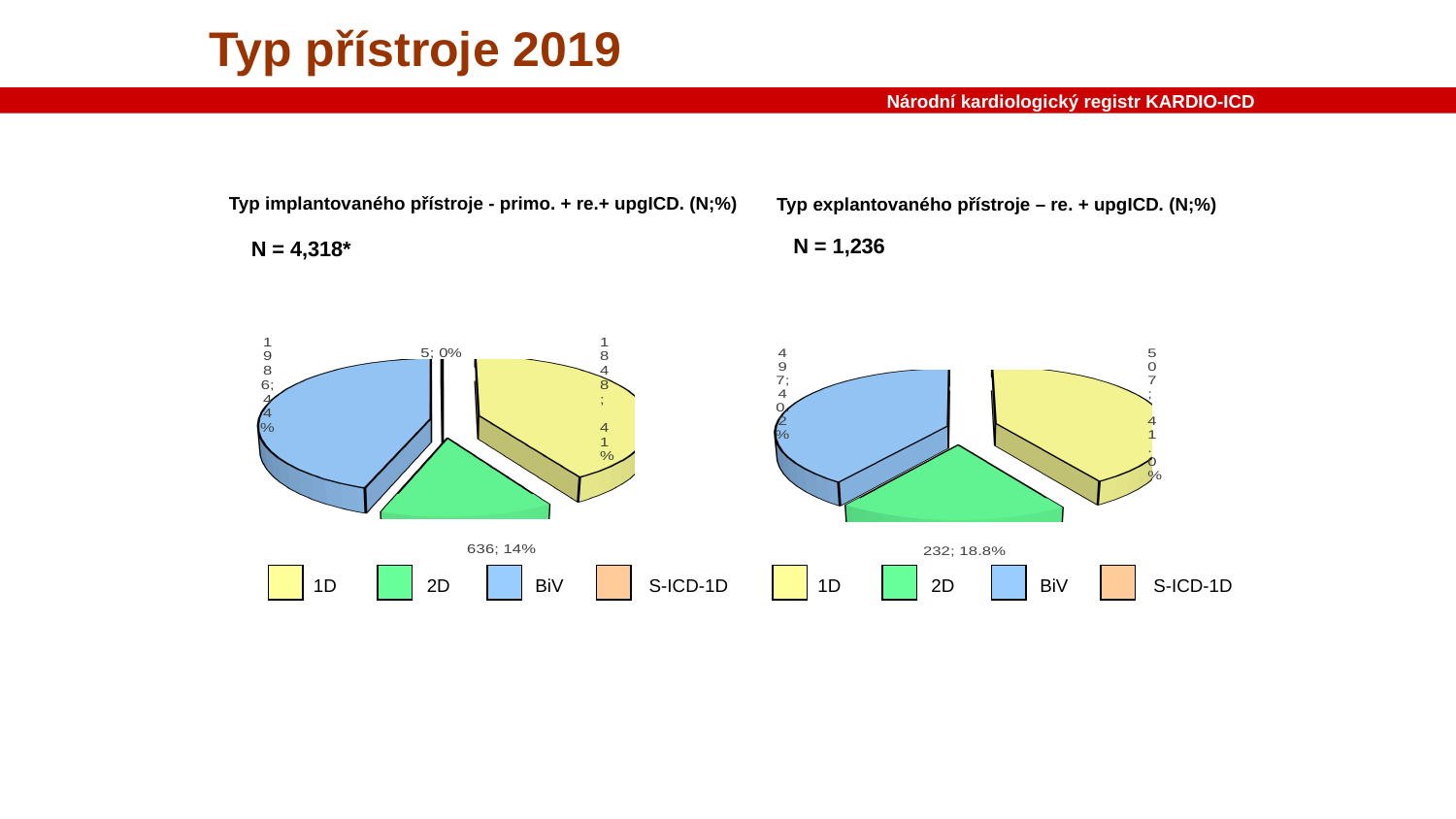
In the right chart (Typ explantovaného přístroje), what is the label shown for the BiV slice? 497; 40.2% What kind of chart is used on the left (Typ implantovaného přístroje)? Pie chart In the left chart (Typ implantovaného přístroje), what is the label shown for the 1D slice? 1848; 41% In the right chart (Typ explantovaného přístroje), what is the label shown for the 2D slice? 232; 18.8% In the right chart (Typ explantovaného přístroje), which of the three labelled device types has the smallest slice? 2D In the right chart (Typ explantovaného přístroje), what is the label shown for the 1D slice? 507; 41.0% In the left chart (Typ implantovaného přístroje), which device type has the largest slice? BiV In the left chart (Typ implantovaného přístroje), which device type has the smallest slice? S-ICD-1D In the left chart (Typ implantovaného přístroje), what is the label shown for the S-ICD-1D slice? 5; 0% In the left chart (Typ implantovaného přístroje), what is the label shown for the 2D slice? 636; 14% What is the N value stated for the right chart (Typ explantovaného přístroje)? N = 1,236 How many entries does the legend of the left chart (Typ implantovaného přístroje) list? 4